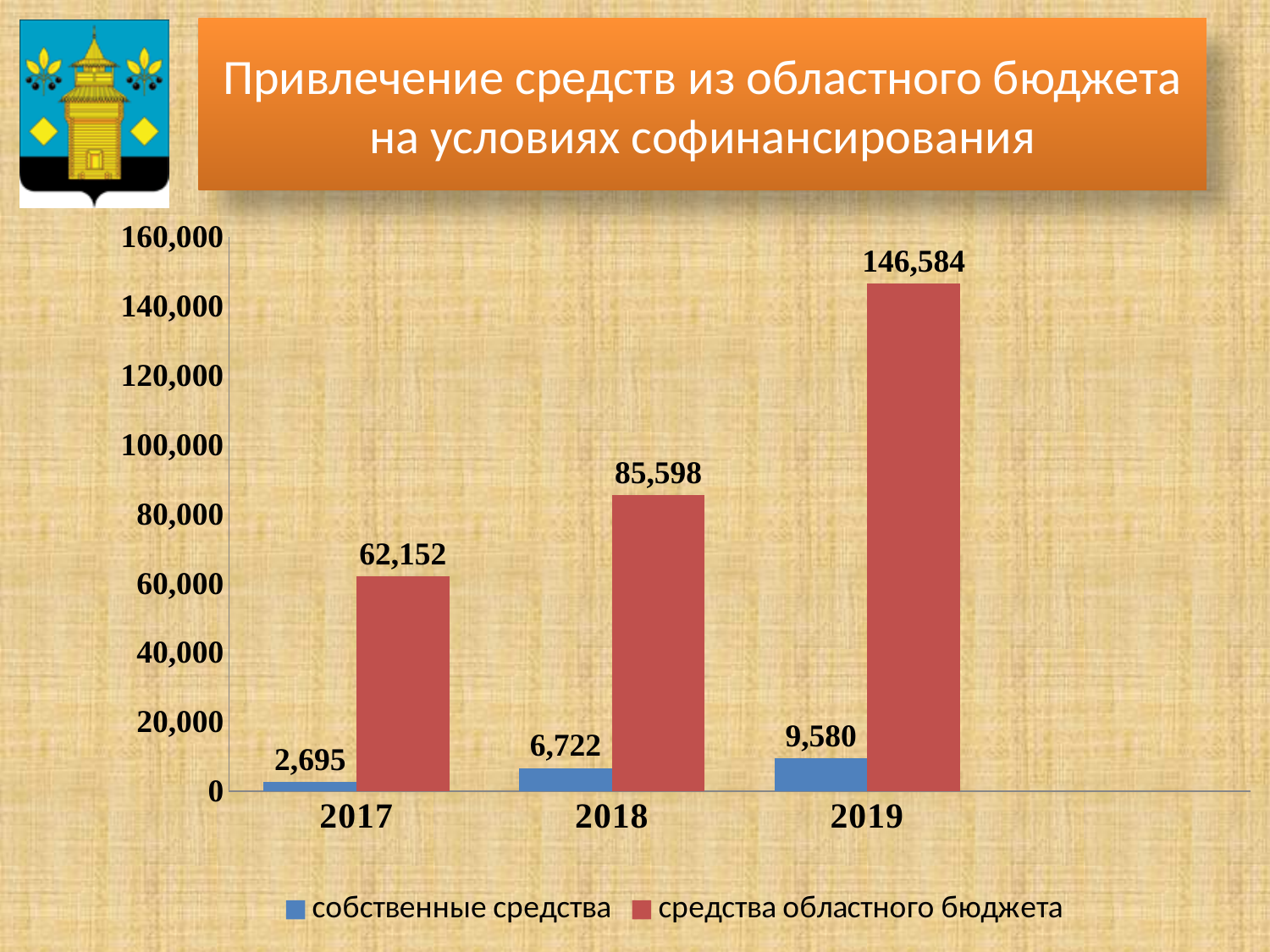
What is the value for собственные средства in 2019? 9,580 Which is larger: средства областного бюджета in 2017 or собственные средства in 2019? средства областного бюджета in 2017 In which year is средства областного бюджета highest? 2019 In which year is собственные средства lowest? 2017 What is the difference between средства областного бюджета in 2019 and in 2018? 60,986 What is the difference between собственные средства in 2019 and in 2018? 2,858 What is the value for собственные средства in 2017? 2,695 What is the value for средства областного бюджета in 2018? 85,598 Do the values for средства областного бюджета rise or fall from 2017 to 2019? rise How many years are shown on the x axis? 3 How many series does the legend list? 2 What is the value for средства областного бюджета in 2019? 146,584